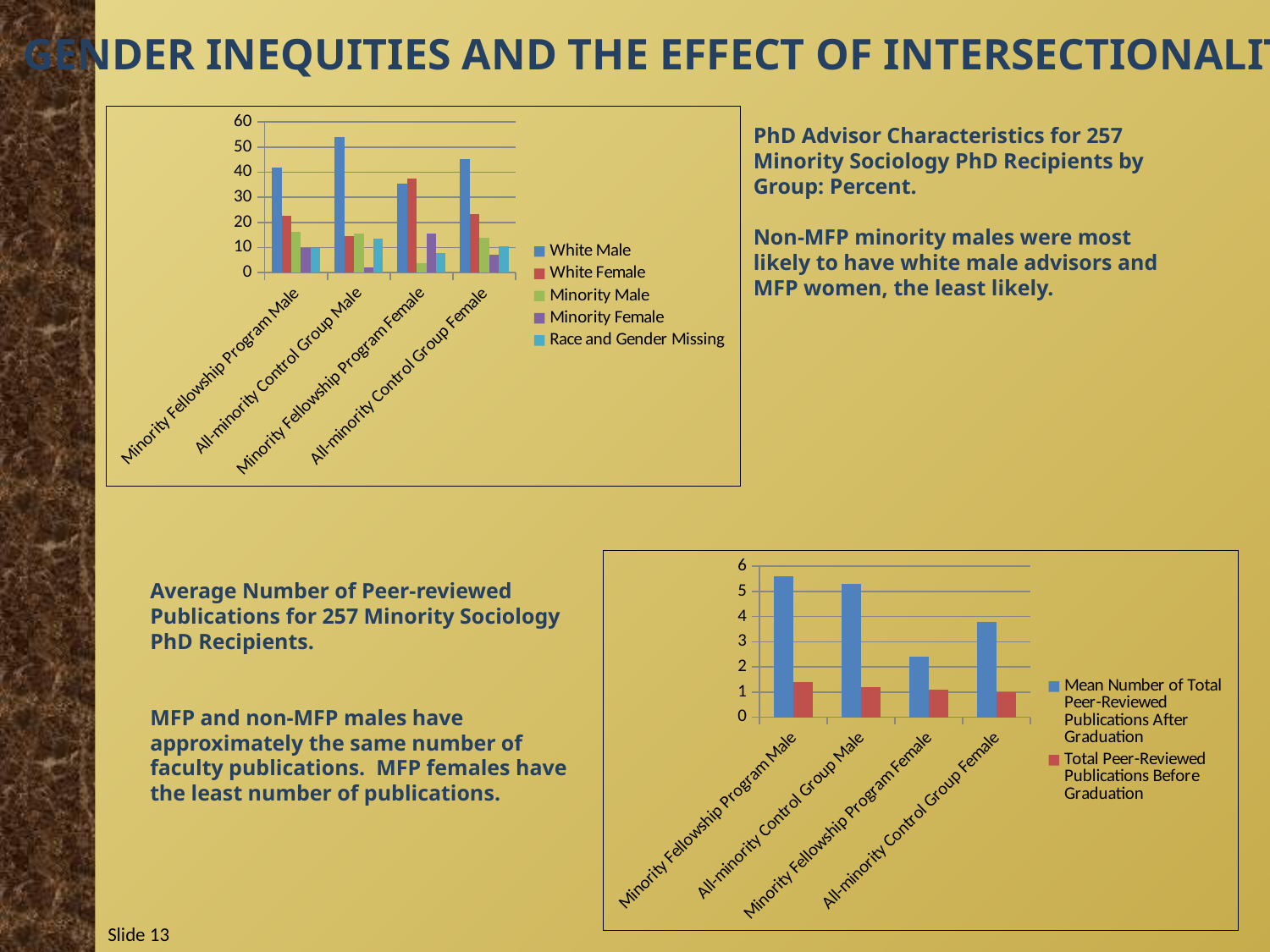
In the bottom chart, for Minority Fellowship Program Male, which is larger: publications after graduation or publications before graduation? after graduation In the top chart, is the White Male value for All-minority Control Group Male greater or less than 50? greater In the top chart, is the Minority Male value for Minority Fellowship Program Female greater or less than 10? less In the bottom chart, is the Mean Number of Total Peer-Reviewed Publications After Graduation for Minority Fellowship Program Female greater or less than 3? less What kind of chart is the top chart on the slide? bar chart In the top chart, which category has the lowest White Male value? Minority Fellowship Program Female In the bottom chart, which category has the lowest Mean Number of Total Peer-Reviewed Publications After Graduation? Minority Fellowship Program Female In the top chart, which is larger for Minority Fellowship Program Male: the White Male value or the White Female value? White Male How many series does the legend of the bottom chart list? 2 In the top chart, which category has the highest White Male value? All-minority Control Group Male How many categories are shown on the x axis of the top chart? 4 How many series does the legend of the top chart list? 5